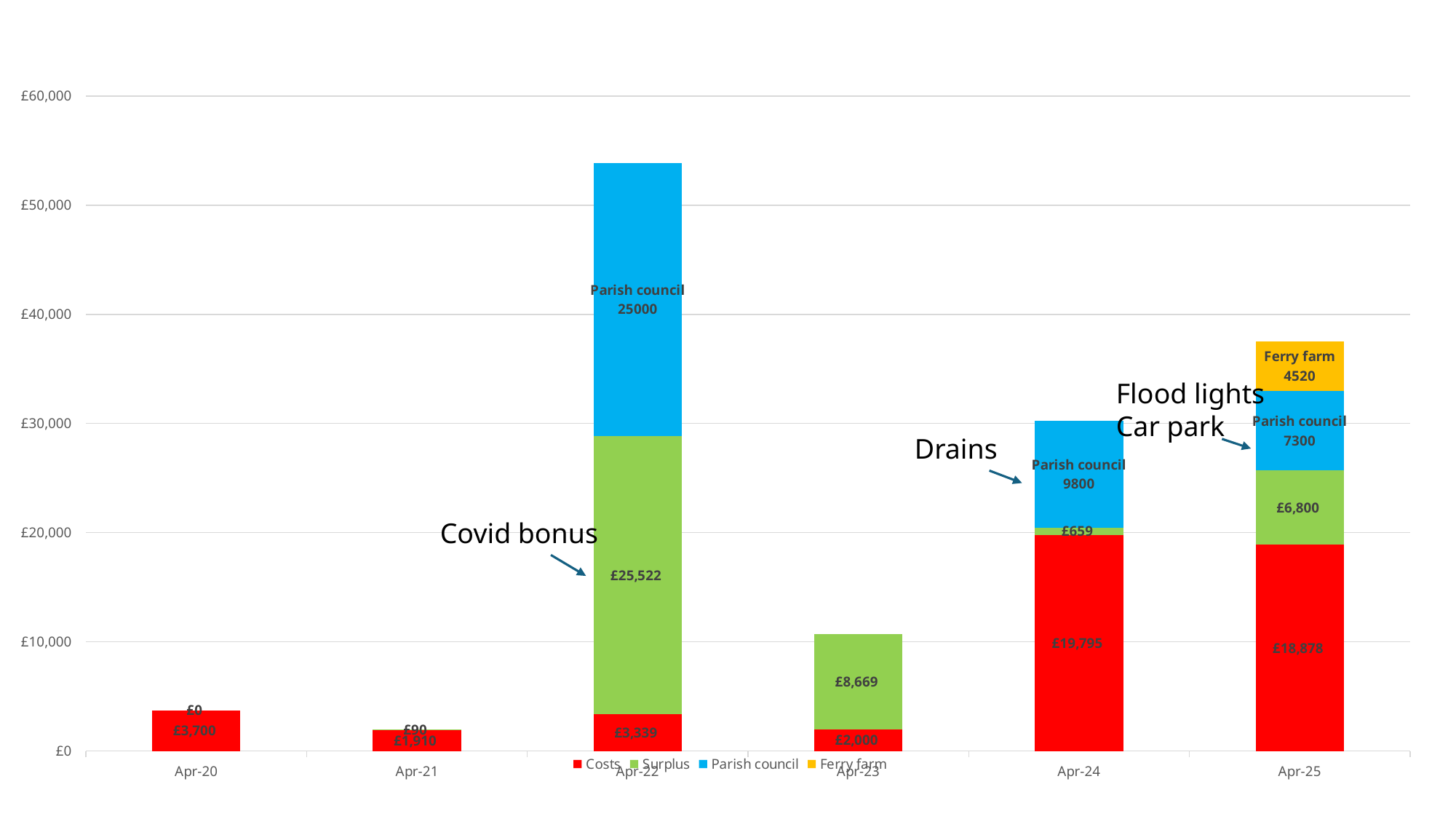
Which is larger, the Parish council value for Apr-24 or for Apr-25? Apr-24 What is the Costs value for Apr-24? £19,795 What is the difference between the Costs values for Apr-24 and Apr-25? £917 Which category has the lowest Costs value? Apr-21 What is the Parish council value for Apr-25? 7300 What is the total of the Apr-25 stacked bar? £37,498 Which category has the highest Surplus value? Apr-22 What is the Ferry farm value for Apr-25? 4520 What is the Surplus value for Apr-22? £25,522 How many series does the legend list? 4 How many categories are shown on the x axis? 6 Is the total height of the Apr-22 stacked bar greater or less than £50,000? greater